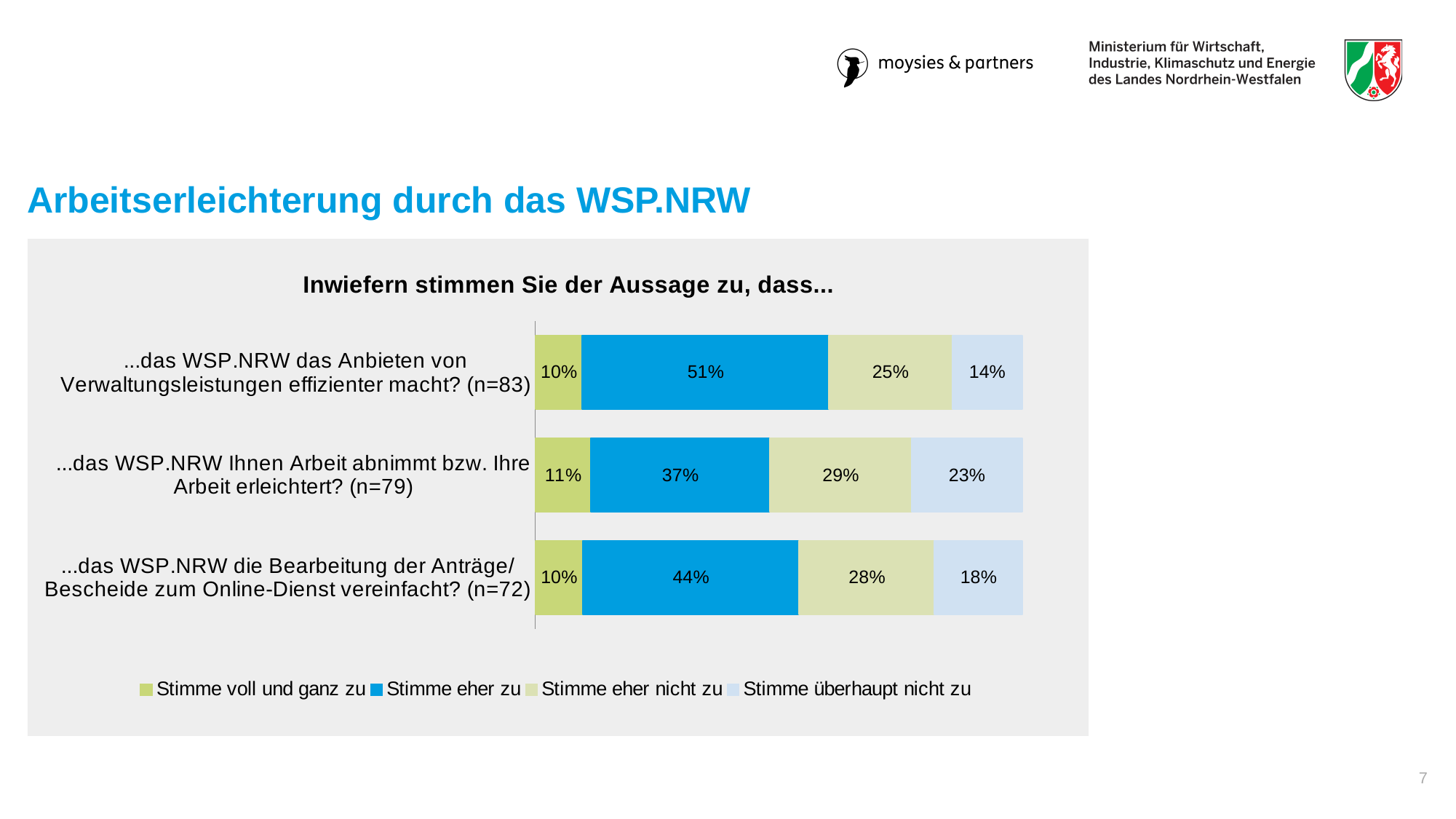
What is the 'Stimme überhaupt nicht zu' value for the statement that the WSP.NRW takes work off you or makes your work easier (n=79)? 23% What is the difference between the 'Stimme eher zu' values for the n=83 statement and the n=79 statement? 14% Which statement has the highest 'Stimme eher zu' value? ...das WSP.NRW das Anbieten von Verwaltungsleistungen effizienter macht? (n=83) What is the total of the stacked bar for the statement about simplifying processing of applications/notices (n=72)? 100% What is the 'Stimme eher zu' value for the statement that the WSP.NRW makes offering administrative services more efficient (n=83)? 51% What is the 'Stimme voll und ganz zu' value for the statement about the WSP.NRW taking work off you (n=79)? 11% Which statement has the lowest 'Stimme überhaupt nicht zu' value? ...das WSP.NRW das Anbieten von Verwaltungsleistungen effizienter macht? (n=83) What is the 'Stimme eher nicht zu' value for the statement that the WSP.NRW simplifies processing applications/notices for the online service (n=72)? 28% What kind of chart is shown on the slide? Stacked bar chart Which is larger: the 'Stimme eher nicht zu' value for the n=79 statement or for the n=72 statement? n=79 statement (29%) How many series does the legend list? 4 How many statements (categories) are shown in the chart? 3